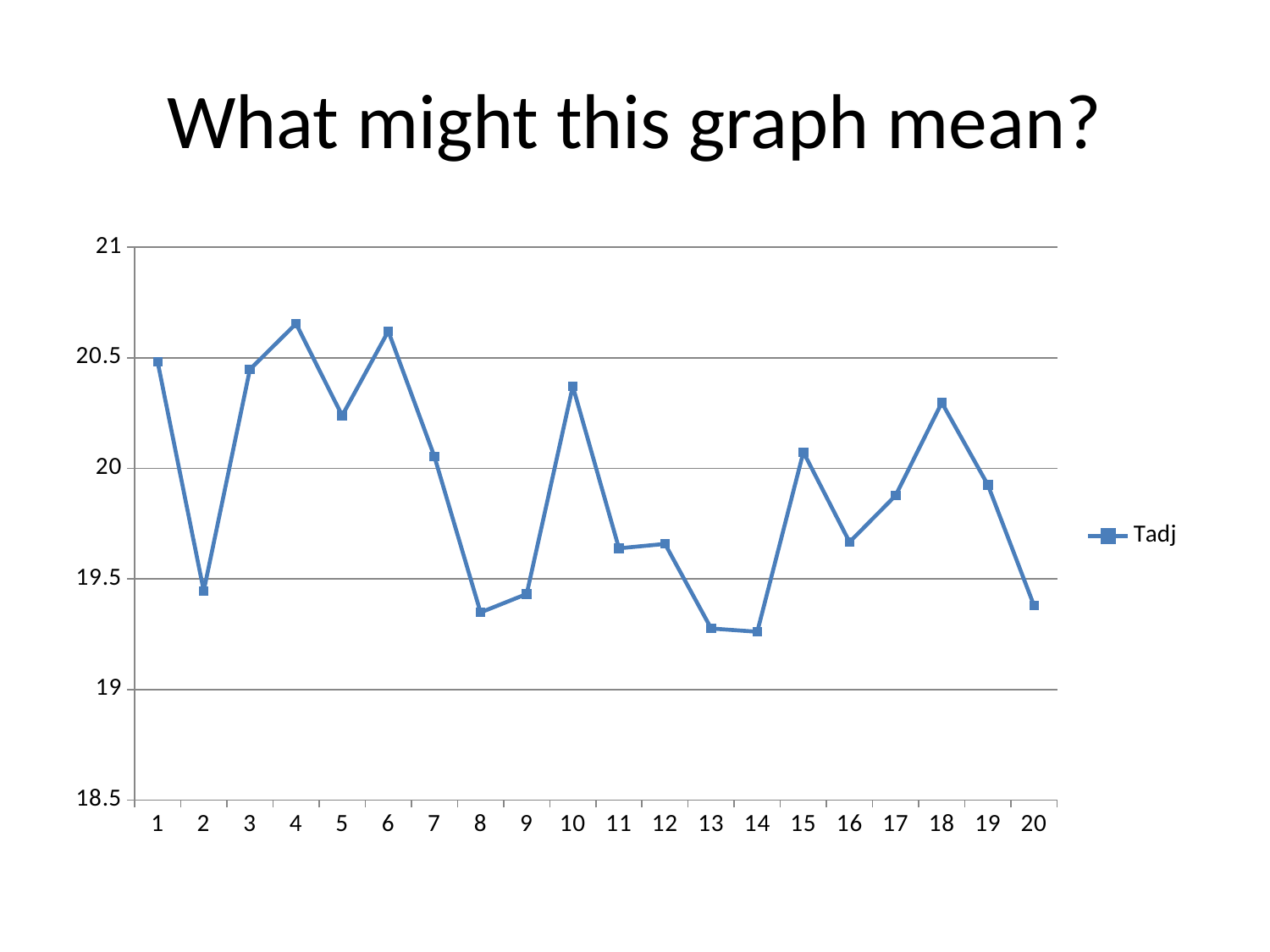
Is the value for point 2 greater or less than 19.5? less Which has the larger value, point 10 or point 11? point 10 Which has the larger value, point 4 or point 2? point 4 What is the name of the series shown in the legend? Tadj Is the value for point 4 greater or less than 20.5? greater From point 6 to point 8, do the values rise or fall? fall What kind of chart is shown on the slide? line chart Is the value for point 18 greater or less than 20? greater What is the title of the slide containing the chart? What might this graph mean? How many series does the legend list? 1 How many data points are plotted along the x axis? 20